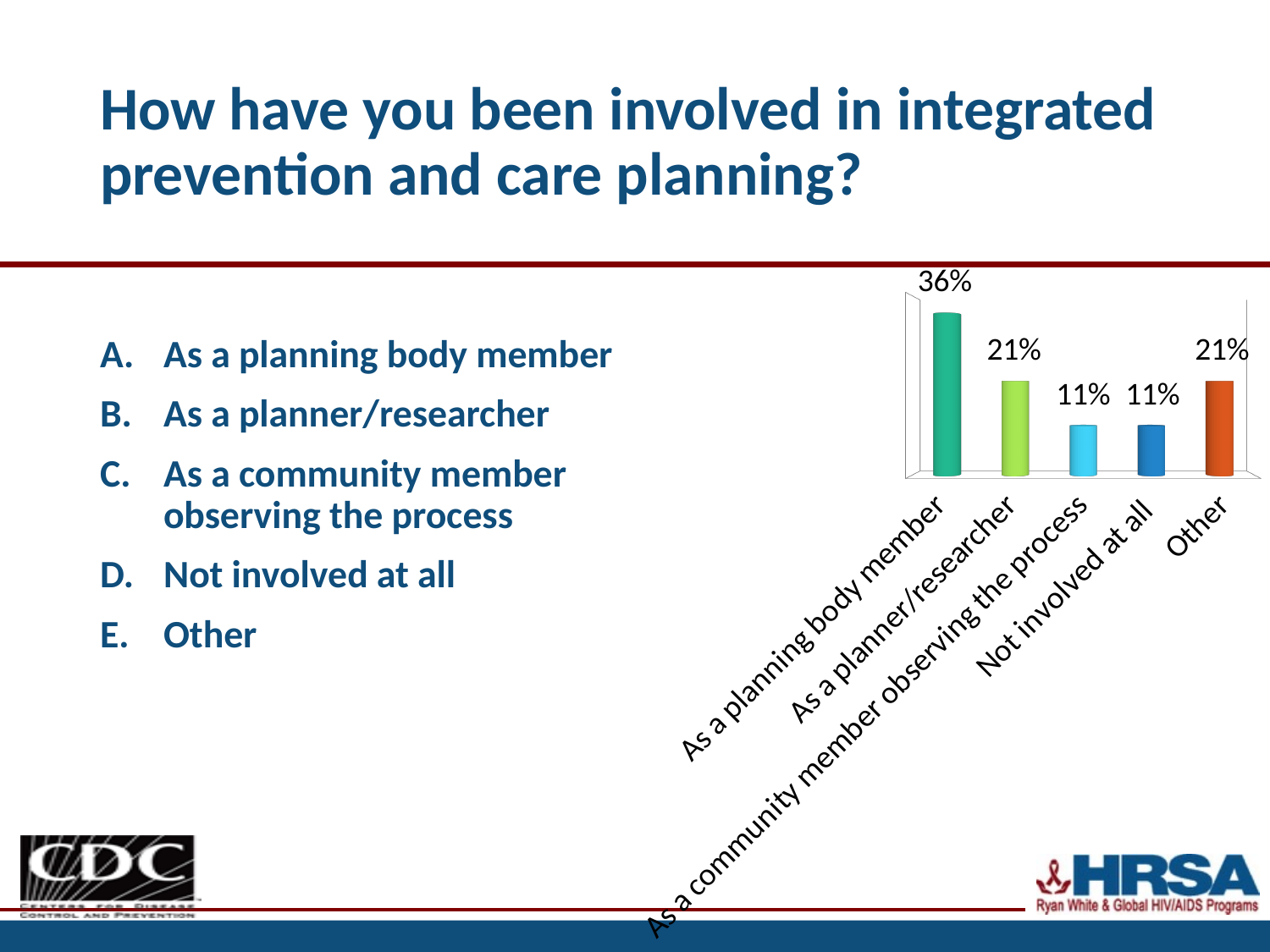
What is the value for 'Not involved at all'? 11% Which is larger, 'As a planning body member' or 'Other'? As a planning body member What kind of chart is shown on the slide? Bar chart How many categories are shown in the chart? 5 Do the values for 'As a planner/researcher' and 'Other' match? Yes, both are 21% What is the value for 'As a planning body member'? 36% What is the difference between 'As a planning body member' and 'As a planner/researcher'? 15% What is the value for 'Other'? 21% What is the value for 'As a planner/researcher'? 21% Which category has the highest value? As a planning body member What is the value for 'As a community member observing the process'? 11% What is the difference between 'Other' and 'Not involved at all'? 10%